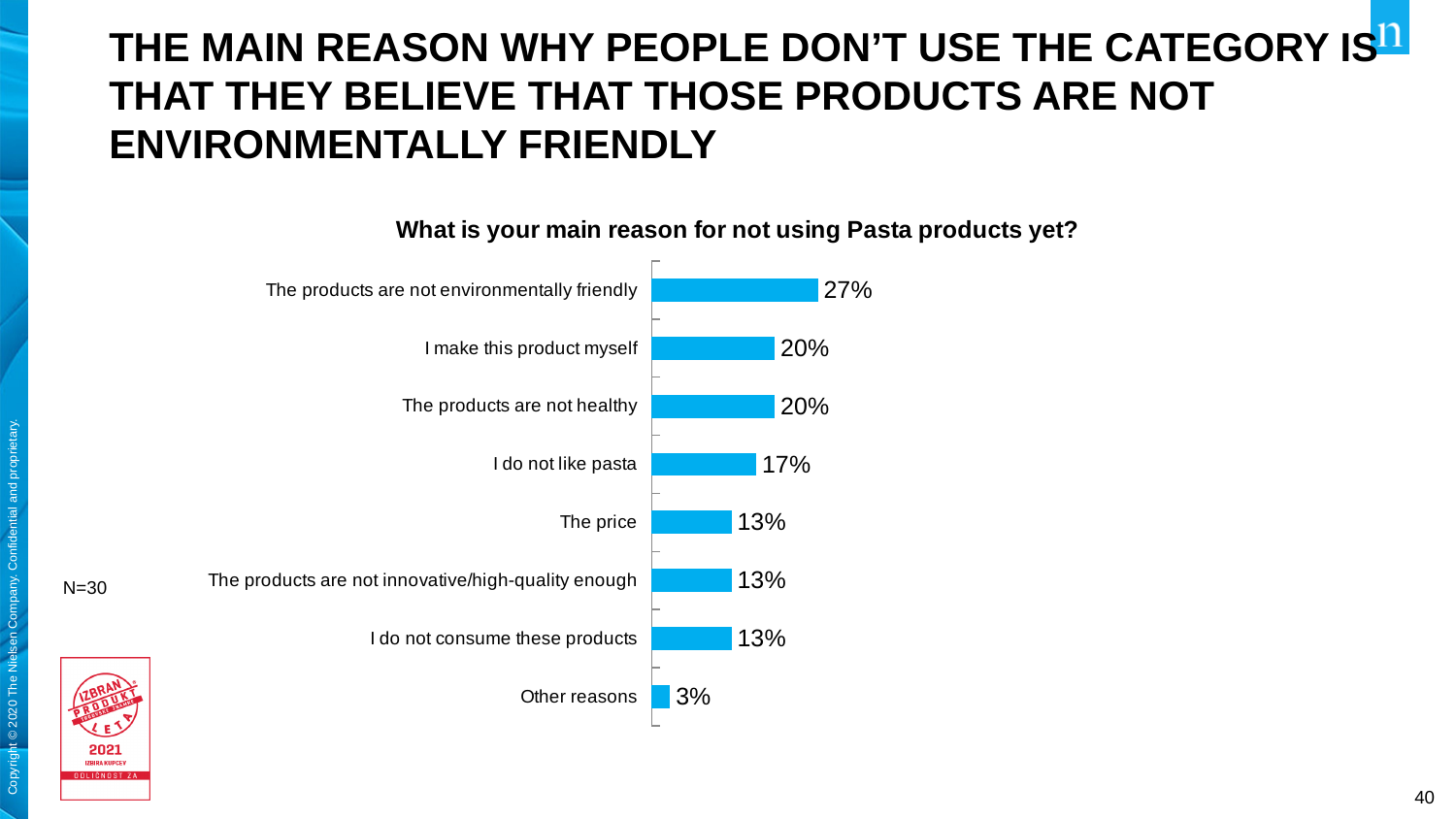
How many reasons are shown in the chart? 8 What is the value for "The price"? 13% What is the title of the chart? What is your main reason for not using Pasta products yet? What is the value for "Other reasons"? 3% Which reason has the highest percentage? The products are not environmentally friendly What is the sample size (N) shown on the slide? N=30 What is the value for "I do not like pasta"? 17% What percentage of respondents said the products are not environmentally friendly? 27% Which reason has the lowest percentage? Other reasons What type of chart is shown on the slide? Bar chart What is the difference between "The products are not environmentally friendly" and "I make this product myself"? 7% Which is larger: "I do not like pasta" or "The price"? I do not like pasta